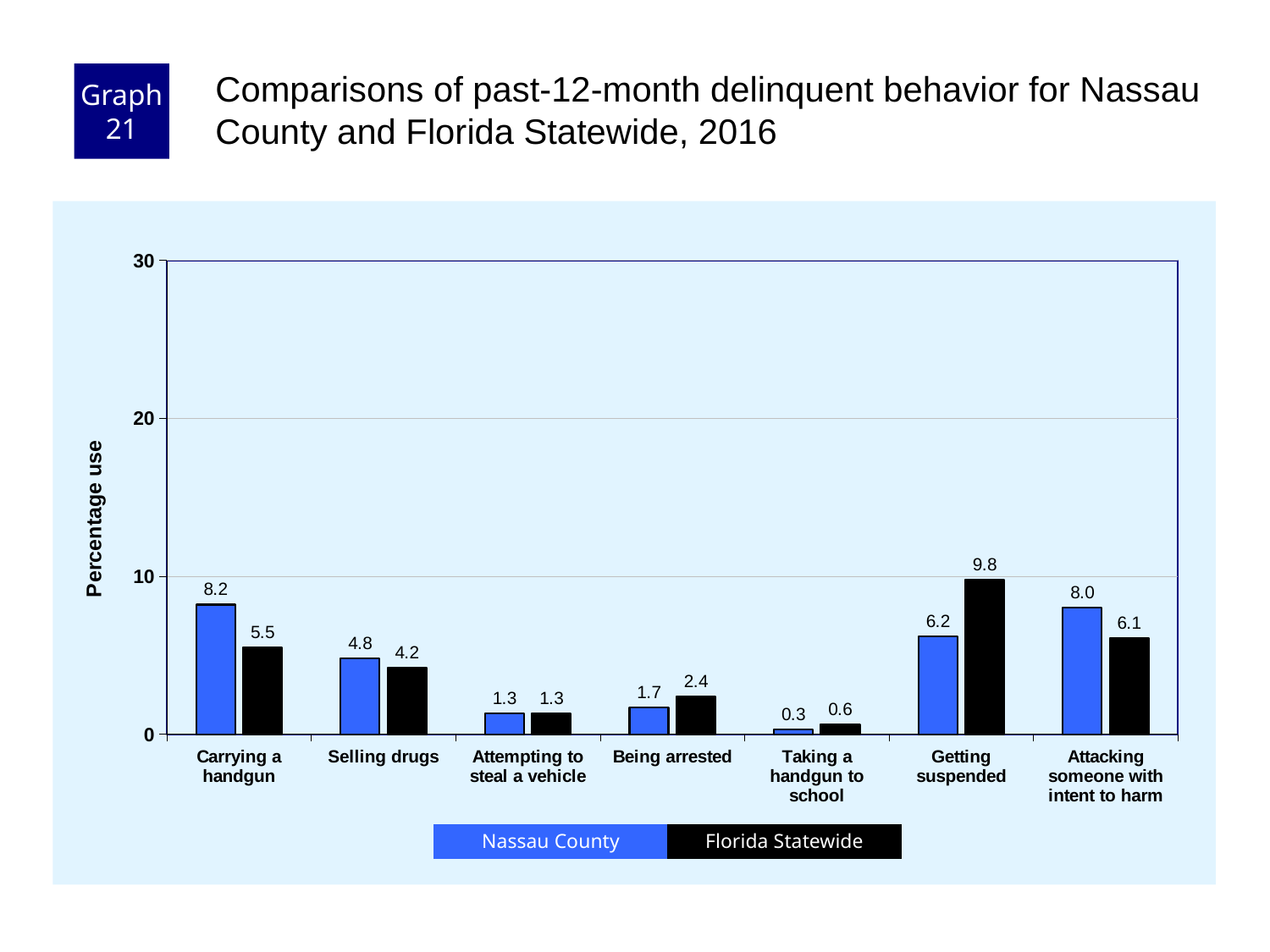
Which category has the highest Florida Statewide value? Getting suspended Is the Florida Statewide value for Getting suspended greater or less than 10? less How many categories are shown on the x axis? 7 What is the difference between the Florida Statewide and Nassau County values for Getting suspended? 3.6 What is the Florida Statewide value for Getting suspended? 9.8 What is the Nassau County value for Carrying a handgun? 8.2 What is the difference between the Nassau County and Florida Statewide values for Carrying a handgun? 2.7 What kind of chart is shown on the slide? bar chart Which category has the lowest Nassau County value? Taking a handgun to school For Being arrested, which is larger: the Nassau County value or the Florida Statewide value? Florida Statewide How many series does the legend list? 2 What is the Nassau County value for Taking a handgun to school? 0.3